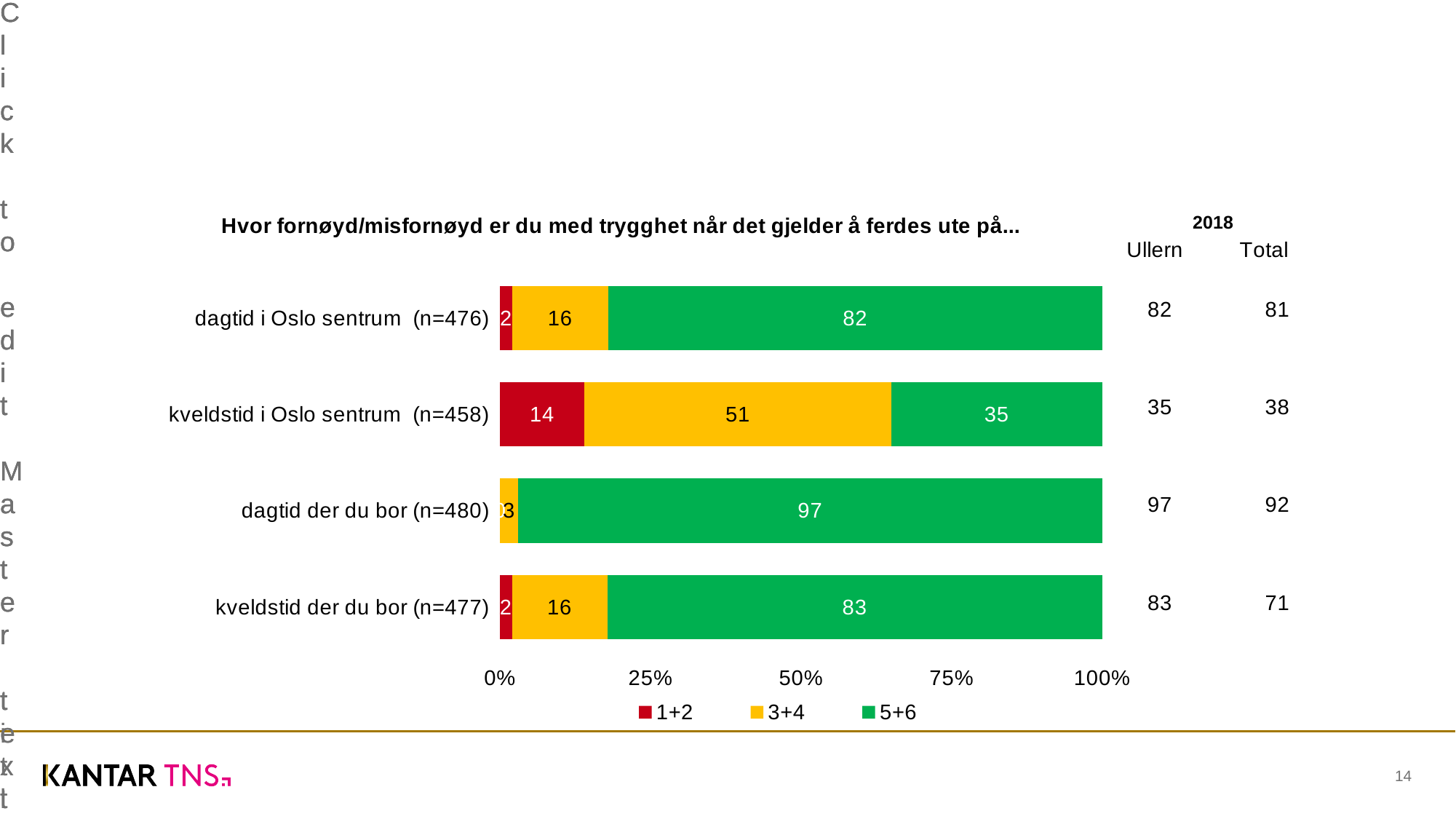
What is the difference between the 5+6 value for dagtid der du bor (n=480) and the 5+6 value for kveldstid i Oslo sentrum (n=458)? 62 What are the legend entries of the chart? 1+2, 3+4, 5+6 What kind of chart is shown on the slide? stacked bar chart Which category has the lowest 5+6 value? kveldstid i Oslo sentrum (n=458) What is the value of the 1+2 segment for kveldstid i Oslo sentrum (n=458)? 14 How many categories are shown in the chart? 4 What is the value of the 3+4 segment for kveldstid i Oslo sentrum (n=458)? 51 Which category has the highest 5+6 value? dagtid der du bor (n=480) How many series does the legend list? 3 Which has the larger 3+4 value: kveldstid i Oslo sentrum (n=458) or dagtid i Oslo sentrum (n=476)? kveldstid i Oslo sentrum (n=458) What is the value of the 5+6 segment for kveldstid i Oslo sentrum (n=458)? 35 What is the value of the 5+6 segment for dagtid i Oslo sentrum (n=476)? 82